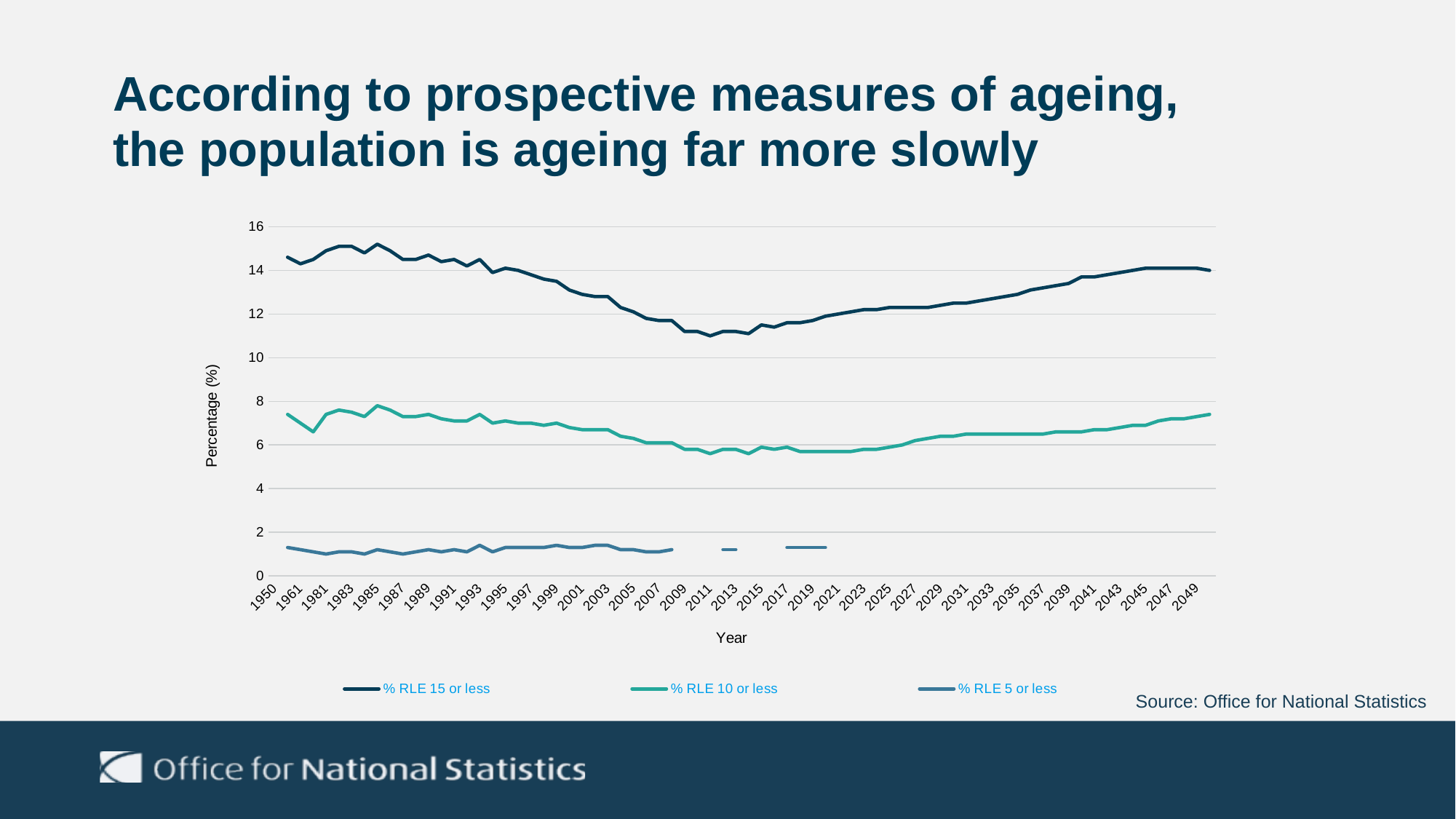
What is the label on the vertical axis of the chart? Percentage (%) Does the % RLE 15 or less line rise or fall between 2011 and 2049? Rises Is the value for % RLE 15 or less in 1985 greater or less than 14? greater In 2011, which is larger: % RLE 15 or less or % RLE 10 or less? % RLE 15 or less Is the value for % RLE 10 or less in 2049 greater or less than 6? greater What kind of chart is shown on the slide? Line chart Which series has the highest values across the whole chart? % RLE 15 or less Does the % RLE 10 or less line rise or fall between 1985 and 2011? Falls Is the value for % RLE 15 or less in 2011 greater or less than 12? less How many series does the legend list? 3 Which series has the lowest values across the whole chart? % RLE 5 or less